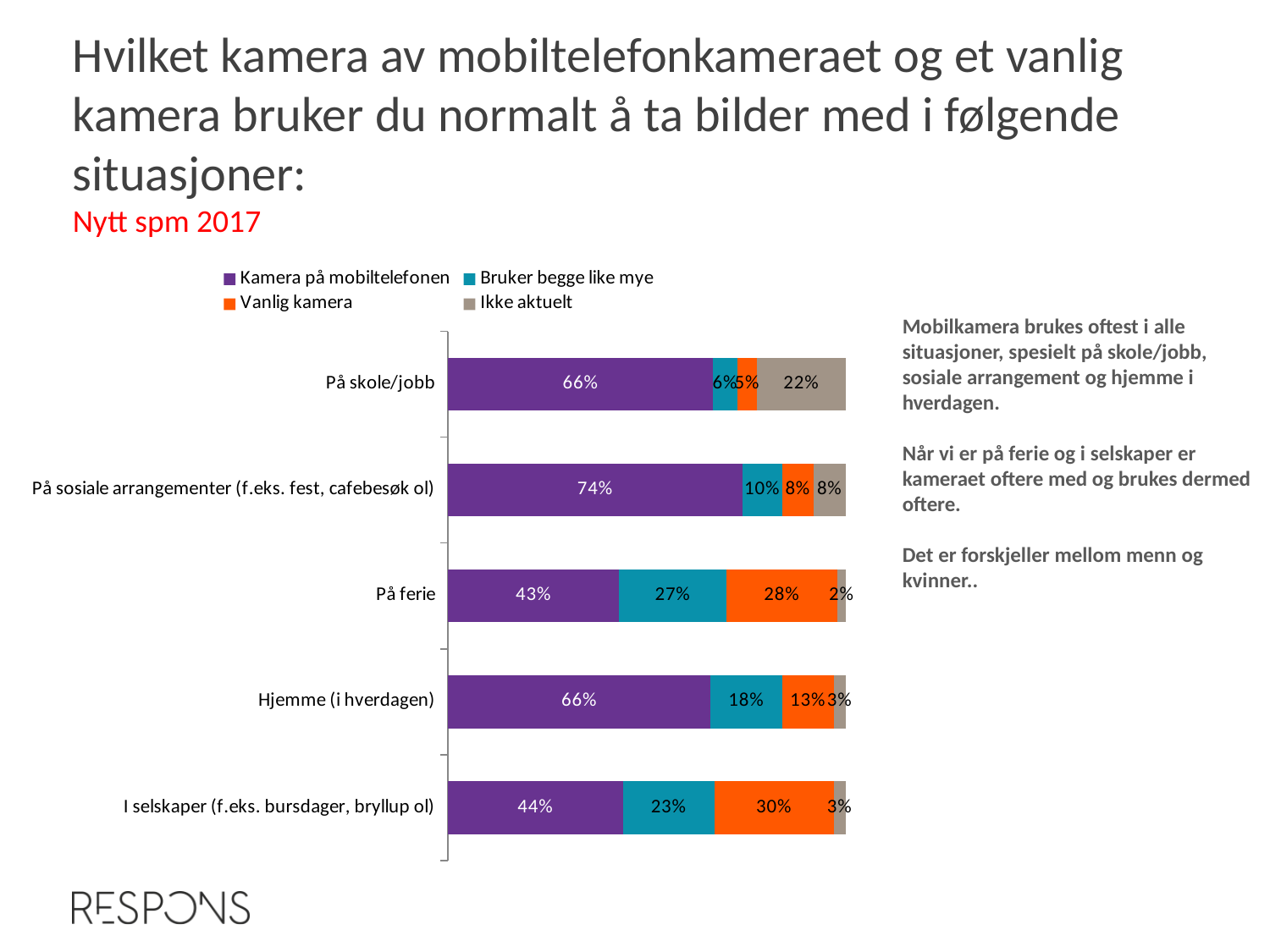
What is the value for 'Ikke aktuelt' in the 'På skole/jobb' category? 22% Which is larger: the 'Bruker begge like mye' value for 'På ferie' or for 'I selskaper (f.eks. bursdager, bryllup ol)'? På ferie Which category has the highest value for 'Kamera på mobiltelefonen'? På sosiale arrangementer (f.eks. fest, cafebesøk ol) Which category has the lowest value for 'Kamera på mobiltelefonen'? På ferie What is the value for 'Bruker begge like mye' in the 'Hjemme (i hverdagen)' category? 18% How many series does the legend list? 4 What is the value for 'Kamera på mobiltelefonen' in the 'På sosiale arrangementer (f.eks. fest, cafebesøk ol)' category? 74% What kind of chart is shown on the slide? stacked bar chart How many categories (situations) are shown on the chart? 5 What is the value for 'Vanlig kamera' in the 'På ferie' category? 28% What is the difference between the 'Vanlig kamera' values for 'I selskaper (f.eks. bursdager, bryllup ol)' and 'Hjemme (i hverdagen)'? 17% Which series is shown in orange in the legend? Vanlig kamera